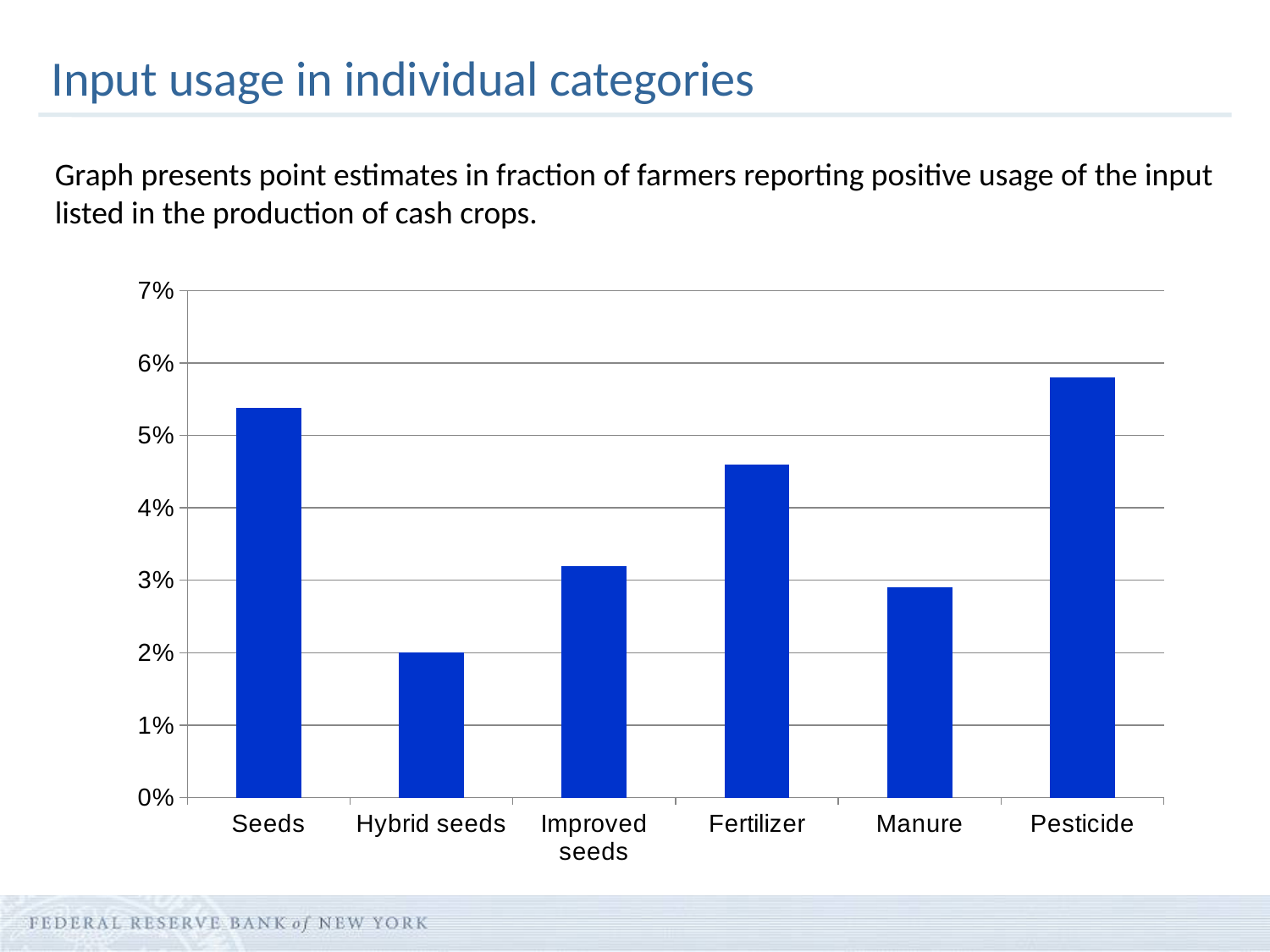
Is the value for Fertilizer greater or less than 4%? greater Which input category has the highest bar in the chart? Pesticide Which is larger in the chart, the value for Improved seeds or the value for Manure? Improved seeds Which is larger in the chart, the value for Seeds or the value for Fertilizer? Seeds How many input categories are shown on the x axis of the chart? 6 What is the highest value shown on the chart's vertical axis? 7% Which input category has the lowest bar in the chart? Hybrid seeds Is the value for Manure greater or less than 3%? less Is the value for Seeds greater or less than 5%? greater What is the value for Hybrid seeds in the chart? 2% What kind of chart is shown on the slide? bar chart